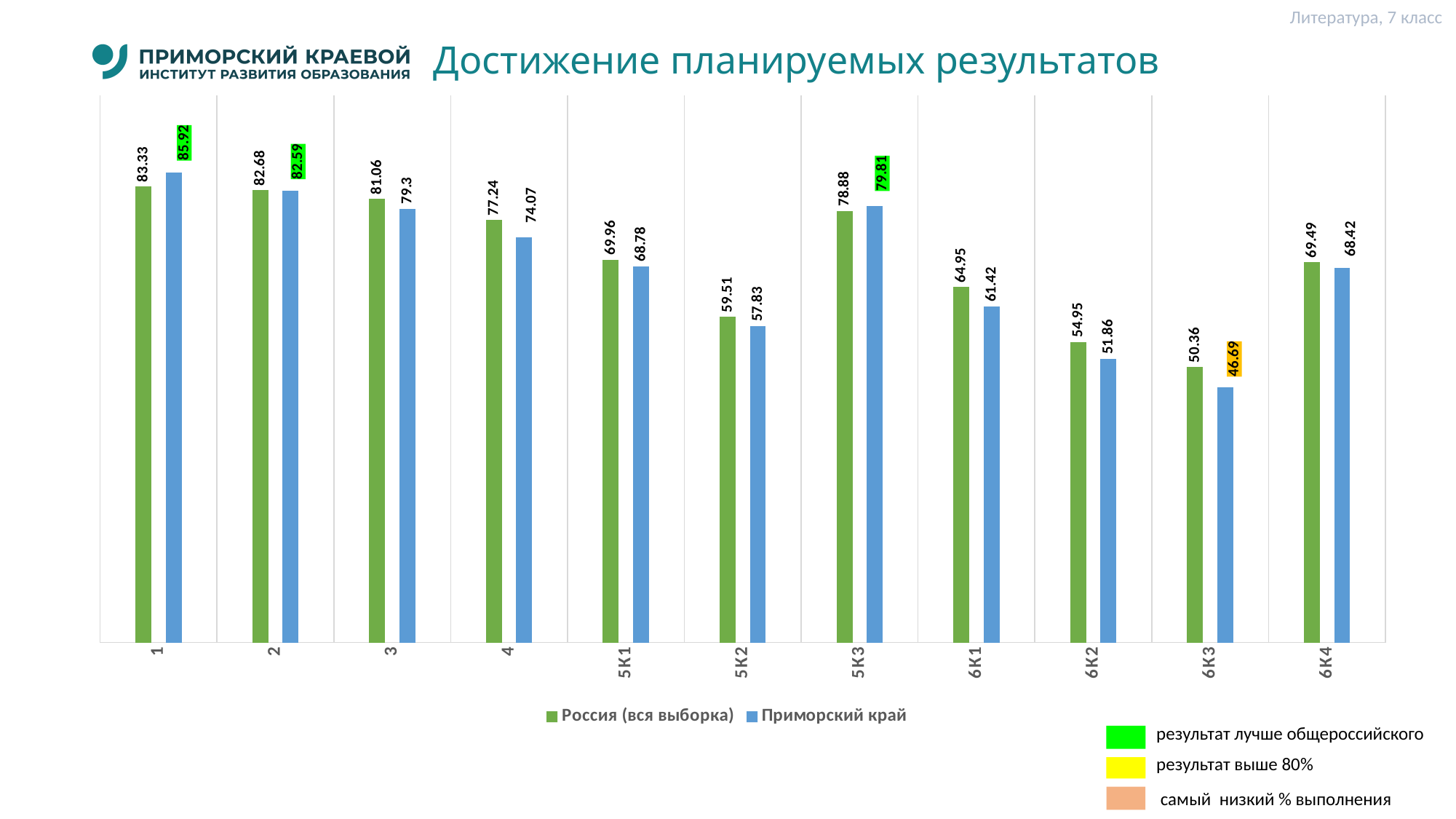
How many series does the legend list? 2 What is the difference between Россия (вся выборка) and Приморский край for category 6К1? 3.53 What colour are the bars for Приморский край? blue What is the value for Приморский край for category 6К3? 46.69 What kind of chart is shown on the slide? bar chart Which category has the lowest value for Приморский край? 6К3 How many categories are shown on the x axis? 11 For category 4, which series has the larger value: Россия (вся выборка) or Приморский край? Россия (вся выборка) Which category has the highest value for Россия (вся выборка)? 1 What is the value for Приморский край for category 1? 85.92 What is the value for Россия (вся выборка) for category 5К3? 78.88 What is the difference between Приморский край and Россия (вся выборка) for category 1? 2.59